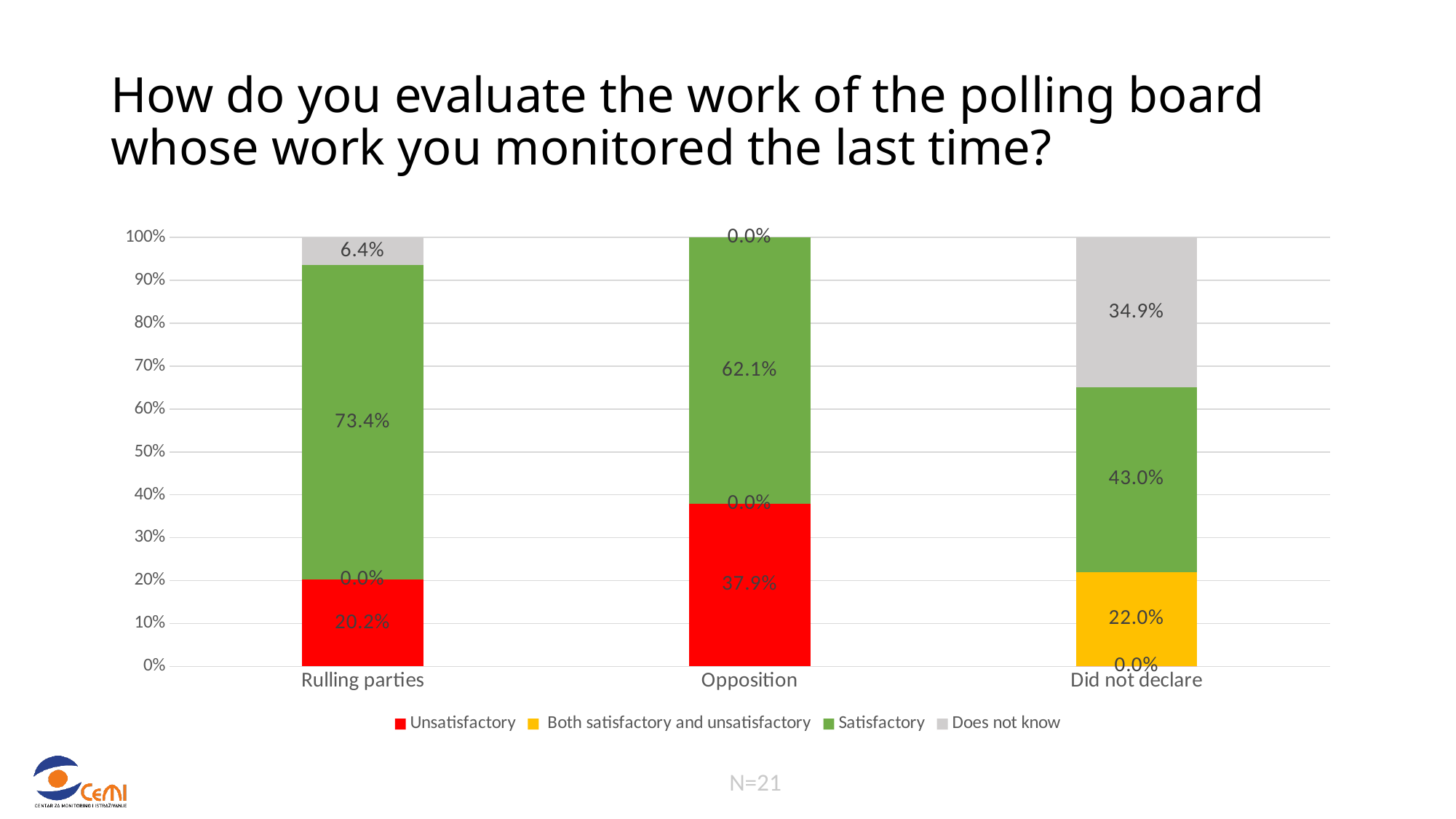
How many categories are shown on the x axis? 3 What is the difference between the Unsatisfactory values for Opposition and Rulling parties? 17.7% What is the Both satisfactory and unsatisfactory value for Did not declare? 22.0% Which is larger: the Satisfactory value for Opposition or for Did not declare? Opposition What is the Satisfactory value for Rulling parties? 73.4% What kind of chart is shown on the slide? stacked bar chart Which category has the highest Satisfactory value? Rulling parties Which category has the lowest Unsatisfactory value? Did not declare What is the Unsatisfactory value for Opposition? 37.9% What is the Does not know value for Did not declare? 34.9% Which series is shown in red in the legend? Unsatisfactory How many series does the legend list? 4